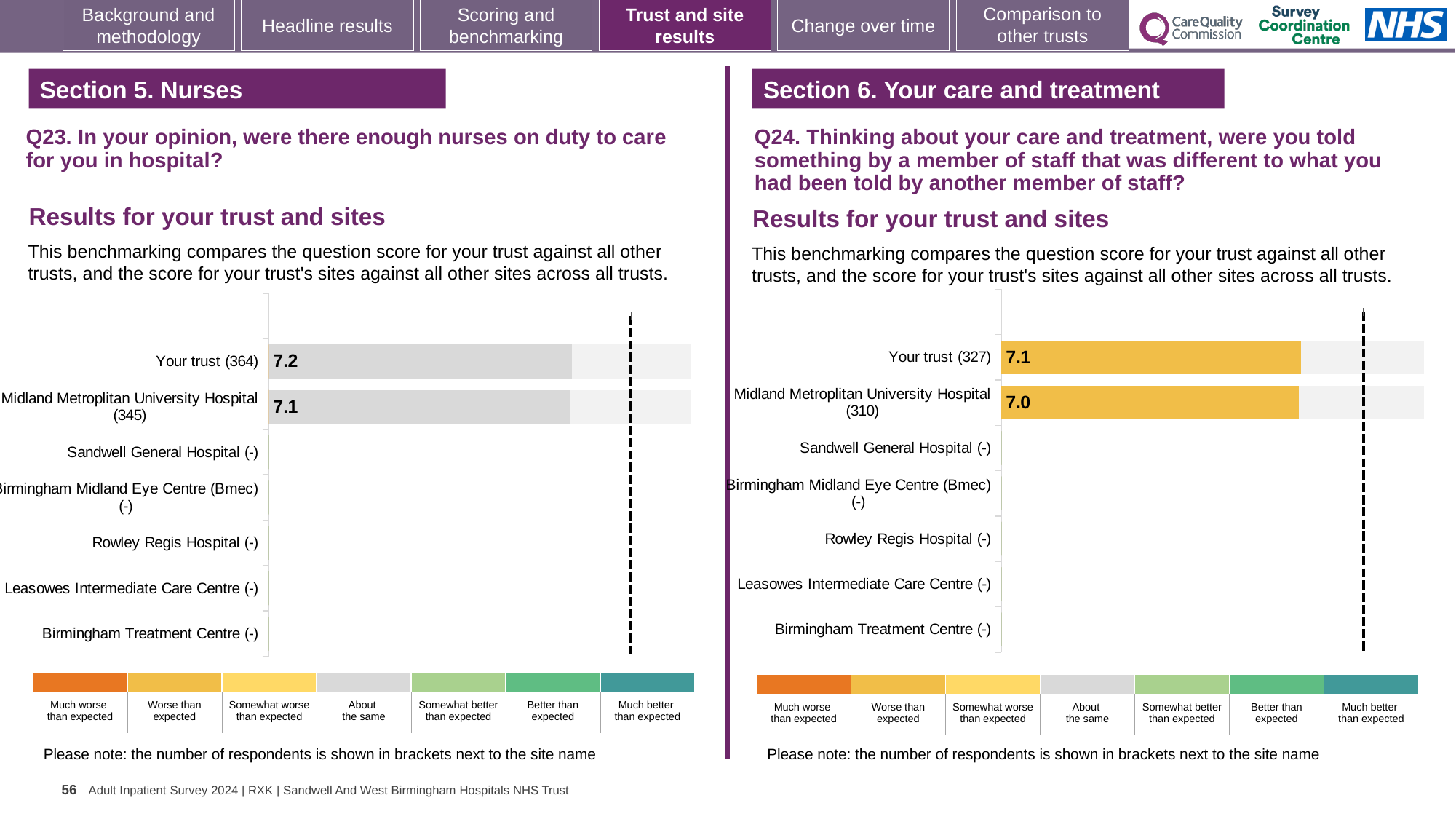
How many site/trust categories are listed on the left chart (Q23)? 7 On the right chart (Q24), which has the higher score: Your trust or Midland Metropolitan University Hospital? Your trust On the right chart (Q24), what is the difference between the score for Your trust and the score for Midland Metropolitan University Hospital? 0.1 On the left chart (Q23), which of the listed sites has the highest score shown? Your trust (364) On the left chart (Q23), what colour are the bars for Your trust and Midland Metropolitan University Hospital, and which benchmark category does that colour represent? Grey, About the same On the left chart (Q23), what is the score for Midland Metropolitan University Hospital (345)? 7.1 On the right chart (Q24, told something different by staff), what is the score for Your trust (327)? 7.1 On the right chart (Q24), how many respondents are shown in brackets for Your trust? 327 On the left chart (Q23), what is the difference between the score for Your trust and the score for Midland Metropolitan University Hospital? 0.1 What type of chart is used on the right side of the slide for Q24? Bar chart On the left chart (Q23, enough nurses on duty), what is the score for Your trust (364)? 7.2 On the right chart (Q24), what is the score for Midland Metropolitan University Hospital (310)? 7.0